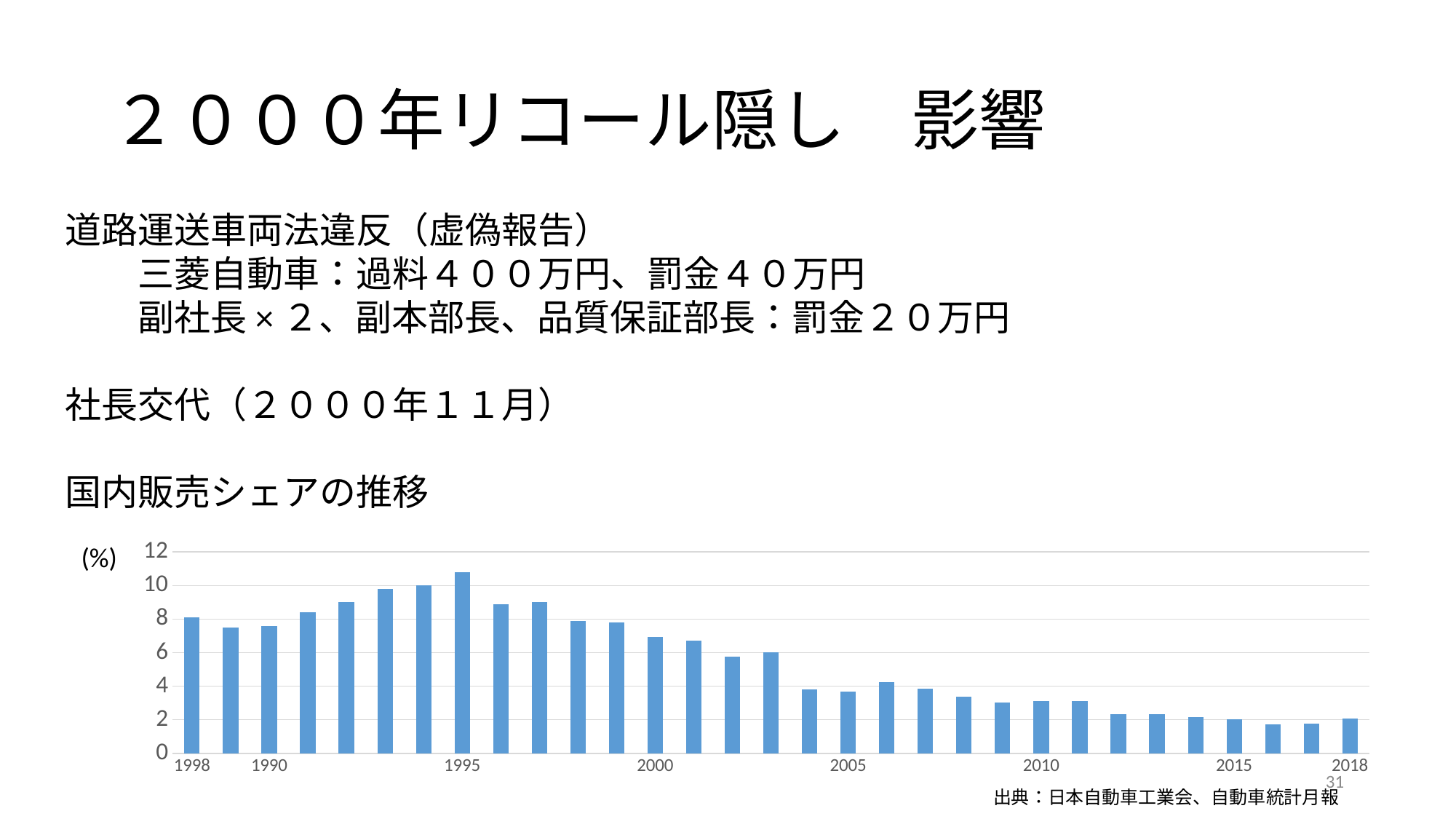
Which year has the larger value, 1995 or 2005? 1995 Which year has the larger value, 2000 or 2010? 2000 What kind of chart is shown under 国内販売シェアの推移? bar chart Is the value for 2000 greater or less than 8? less Is the value for 2015 greater or less than 4? less In which year is the domestic sales share highest? 1995 How many bars are plotted in the chart? 31 Do the values rise or fall from 1995 to 2018? fall What is the maximum value shown on the vertical axis of the chart? 12 Is the value for 1995 greater or less than 10? greater